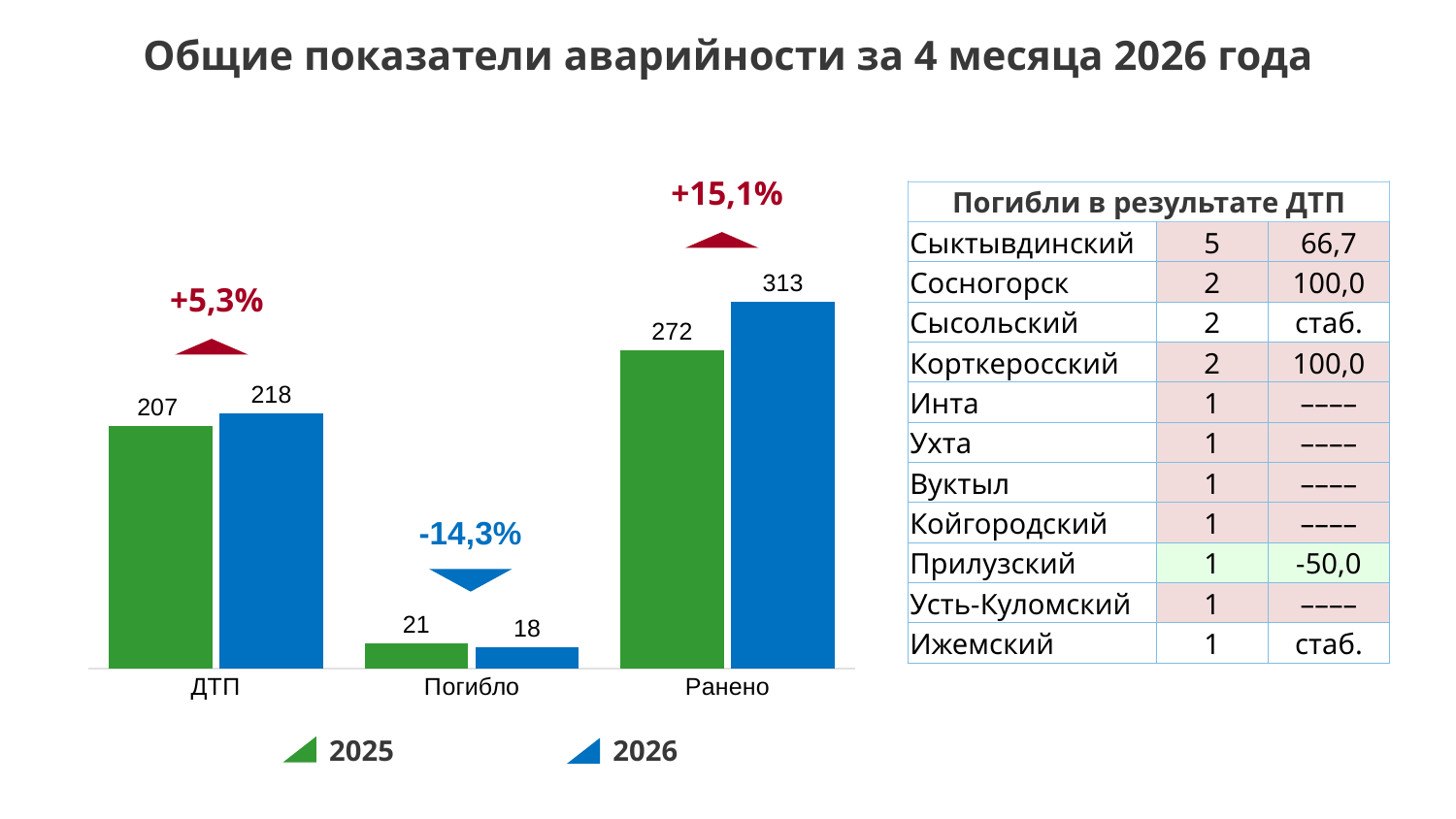
What is the value for 2026 in the ДТП category? 218 What kind of chart is shown on the slide? bar chart How many categories are shown on the x axis of the chart? 3 What percentage change is annotated above the Ранено category? +15,1% What is the difference between the 2026 and 2025 values in the Ранено category? 41 What is the value for 2026 in the Погибло category? 18 How many series does the chart legend list? 2 Which category has the highest value for the 2026 series? Ранено What is the value for 2025 in the Ранено category? 272 What is the difference between the 2025 and 2026 values in the Погибло category? 3 In the ДТП category, which series has the larger value, 2025 or 2026? 2026 Which category has the lowest value for the 2025 series? Погибло